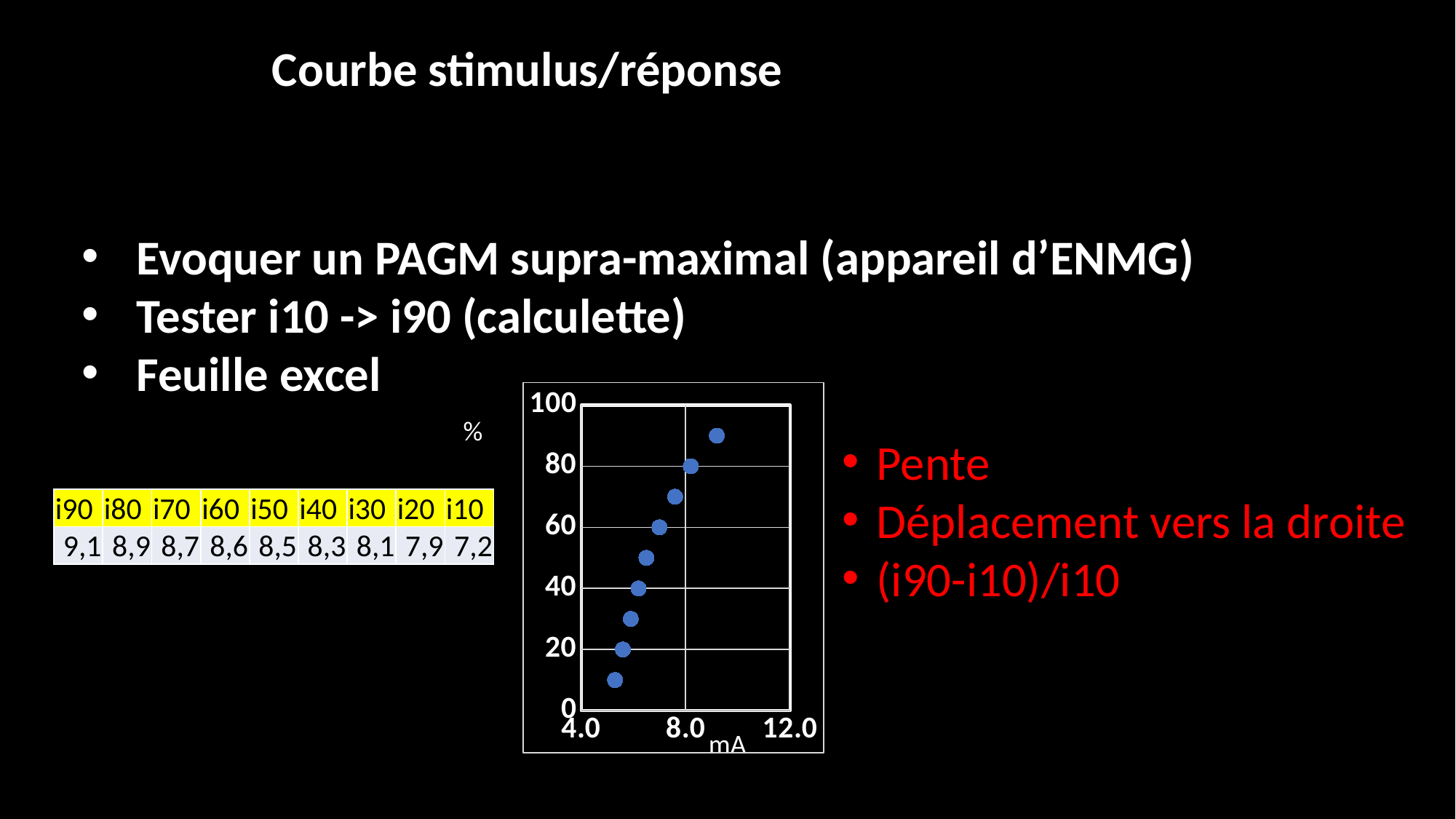
Which point lies further to the right on the chart: the point at 80% or the point at 20%? the point at 80% How many data points are plotted on the chart? 9 Is the x value (mA) of the highest point on the chart greater or less than 8.0? greater What is the label of the x axis of the chart? mA Is the y value (%) of the highest point on the chart greater or less than 80? greater What is the label of the y axis of the chart? % Is the y value (%) of the lowest point on the chart greater or less than 20? less What is the highest value shown on the x axis of the chart? 12.0 Do the plotted values rise or fall as the x axis (mA) increases? rise What is the y value (%) of the second-lowest point on the chart? 20 What kind of chart is shown on the slide? scatter chart